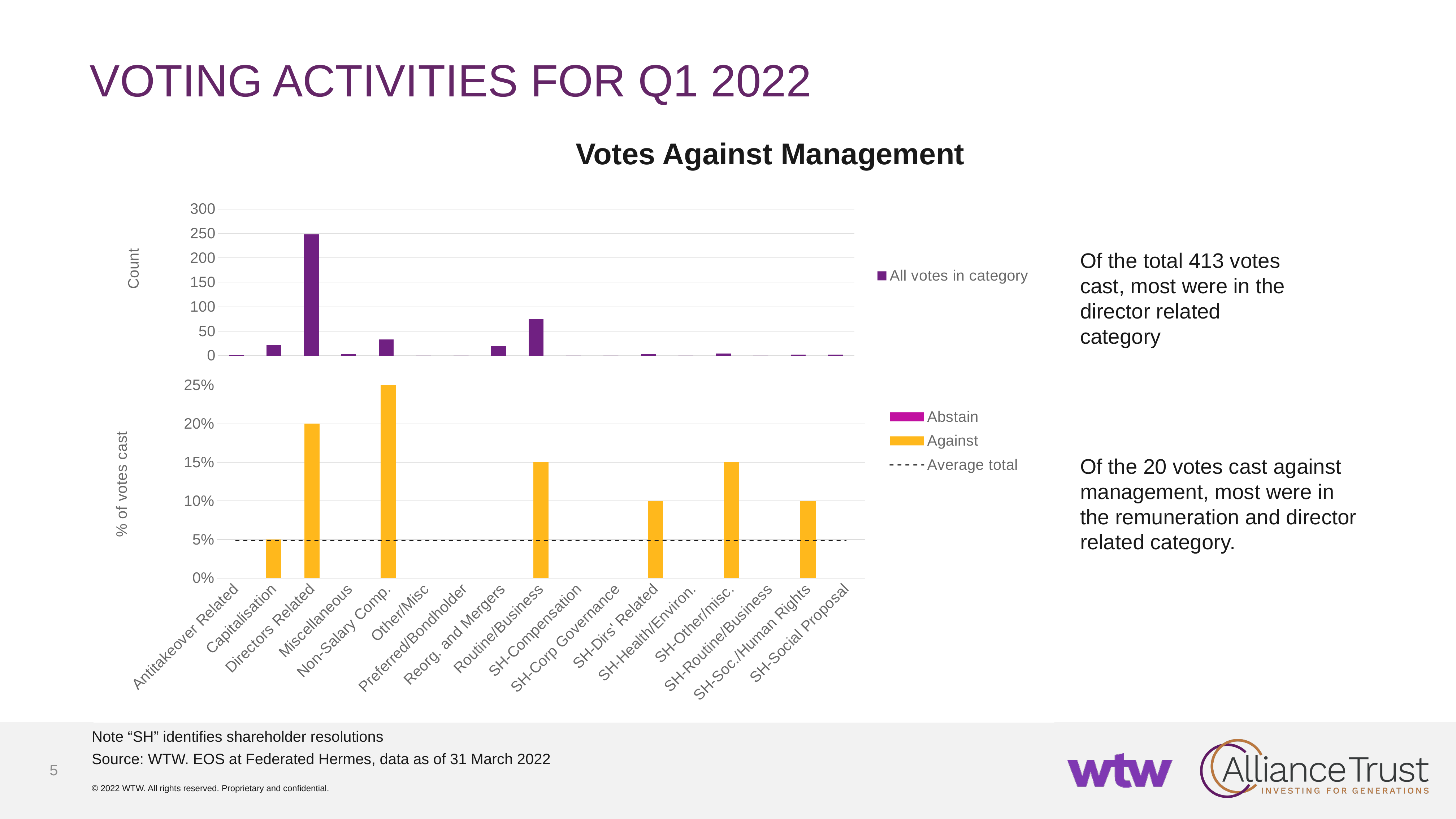
What is the title shown above the charts? Votes Against Management In the bottom '% of votes cast' chart, which is larger, the Against value for Routine/Business or for SH-Dirs' Related? Routine/Business How many categories are shown along the x axis of the charts? 17 In the bottom '% of votes cast' chart, what is the Against value for Directors Related? 20% In the top 'Count' chart, is the value for Capitalisation greater or less than 50? less In the bottom '% of votes cast' chart, how many entries does the legend list? 3 In the bottom '% of votes cast' chart, what is the Against value for Non-Salary Comp.? 25% In the top 'Count' chart, is the value for Routine/Business greater or less than 50? greater In the top 'Count' chart, is the value for Directors Related greater or less than 200? greater In the bottom '% of votes cast' chart, which category has the highest percentage of votes against? Non-Salary Comp. What kind of chart is the top 'Count' chart on the slide? bar chart In the top 'Count' chart, which category has the highest number of votes? Directors Related